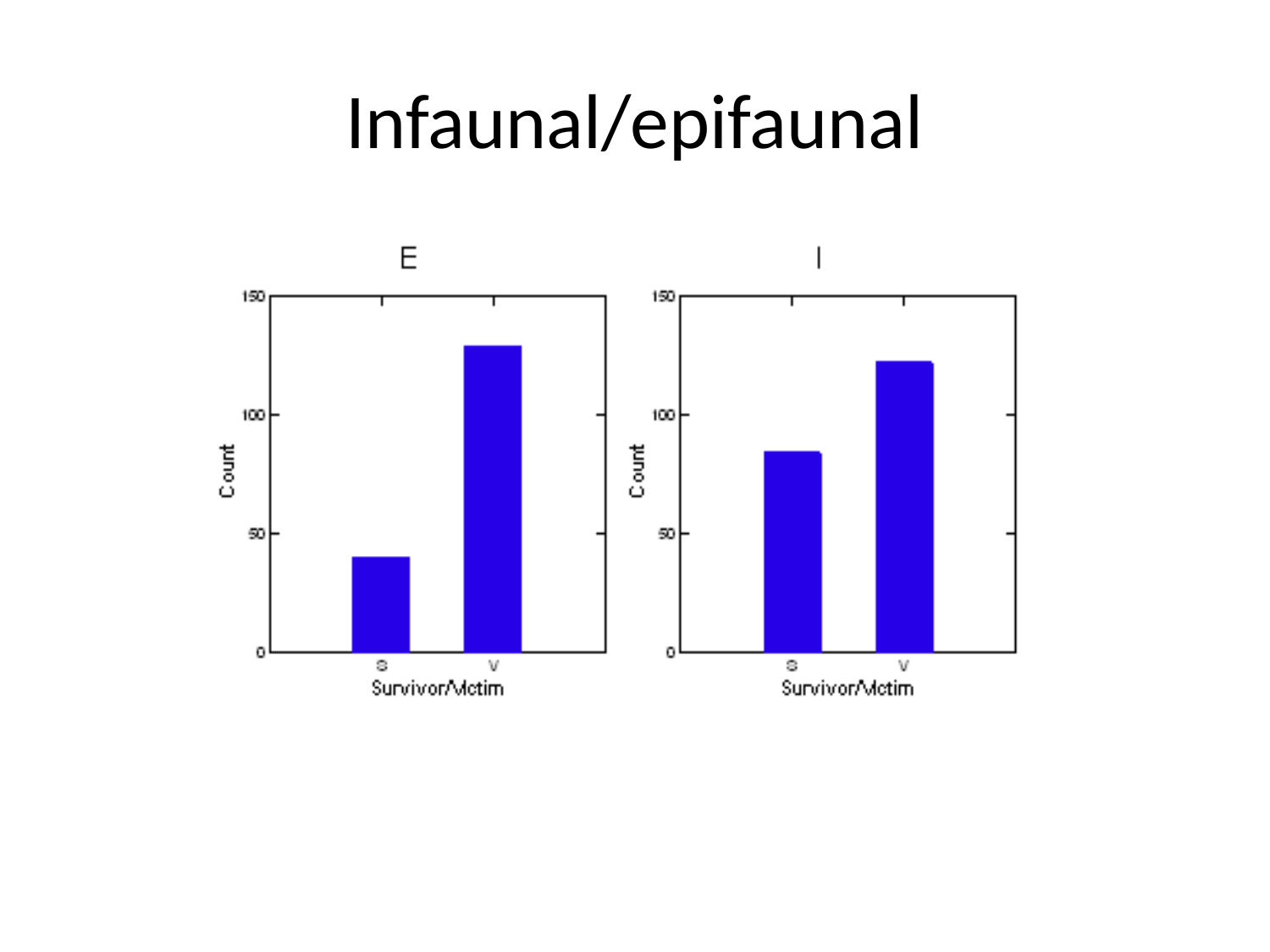
In the chart titled E, is the count for s greater or less than 50? less In the chart titled E, which category has the higher count, s or v? v What is the y-axis label of the chart titled E? Count In the chart titled E, which category has the highest count? v In the chart titled I, is the count for s greater or less than 50? greater What kind of chart is the chart titled I? bar chart In the chart titled I, is the count for s greater or less than 100? less What is the x-axis label of the chart titled I? Survivor/Victim In the chart titled I, which category has the lower count? s How many categories are shown on the x axis of the chart titled E? 2